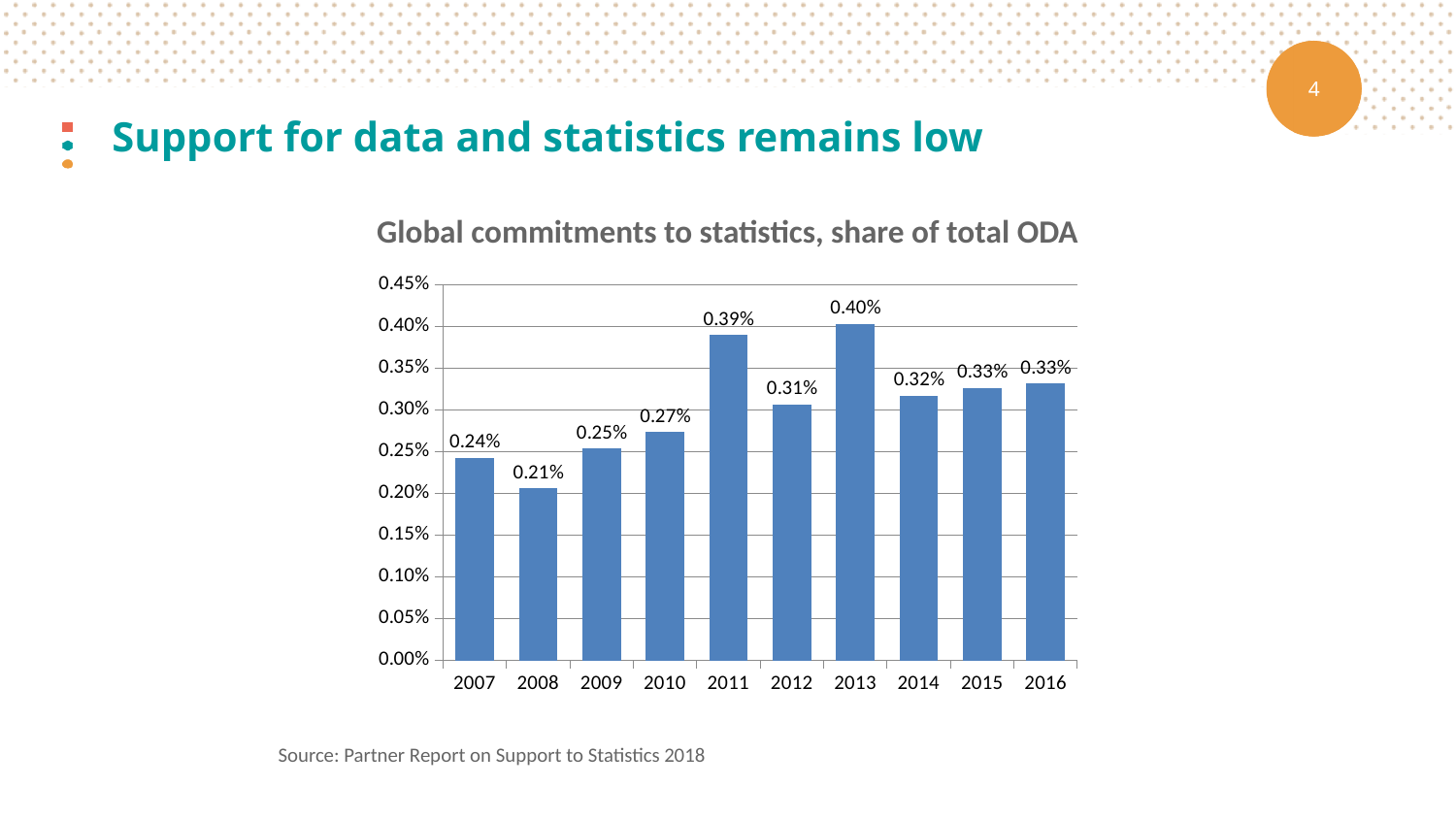
What is the value for 2013? 0.40% What is the difference between the values for 2013 and 2008? 0.19% Is the value for 2011 greater or less than 0.35%? greater Which is larger, the value for 2012 or the value for 2014? 2014 What is the value for 2008? 0.21% What is the value for 2011? 0.39% Which year has the highest value? 2013 What is the value for 2016? 0.33% What is the title of the chart? Global commitments to statistics, share of total ODA What kind of chart is shown on the slide? bar chart How many years are shown on the x axis? 10 Which year has the lowest value? 2008